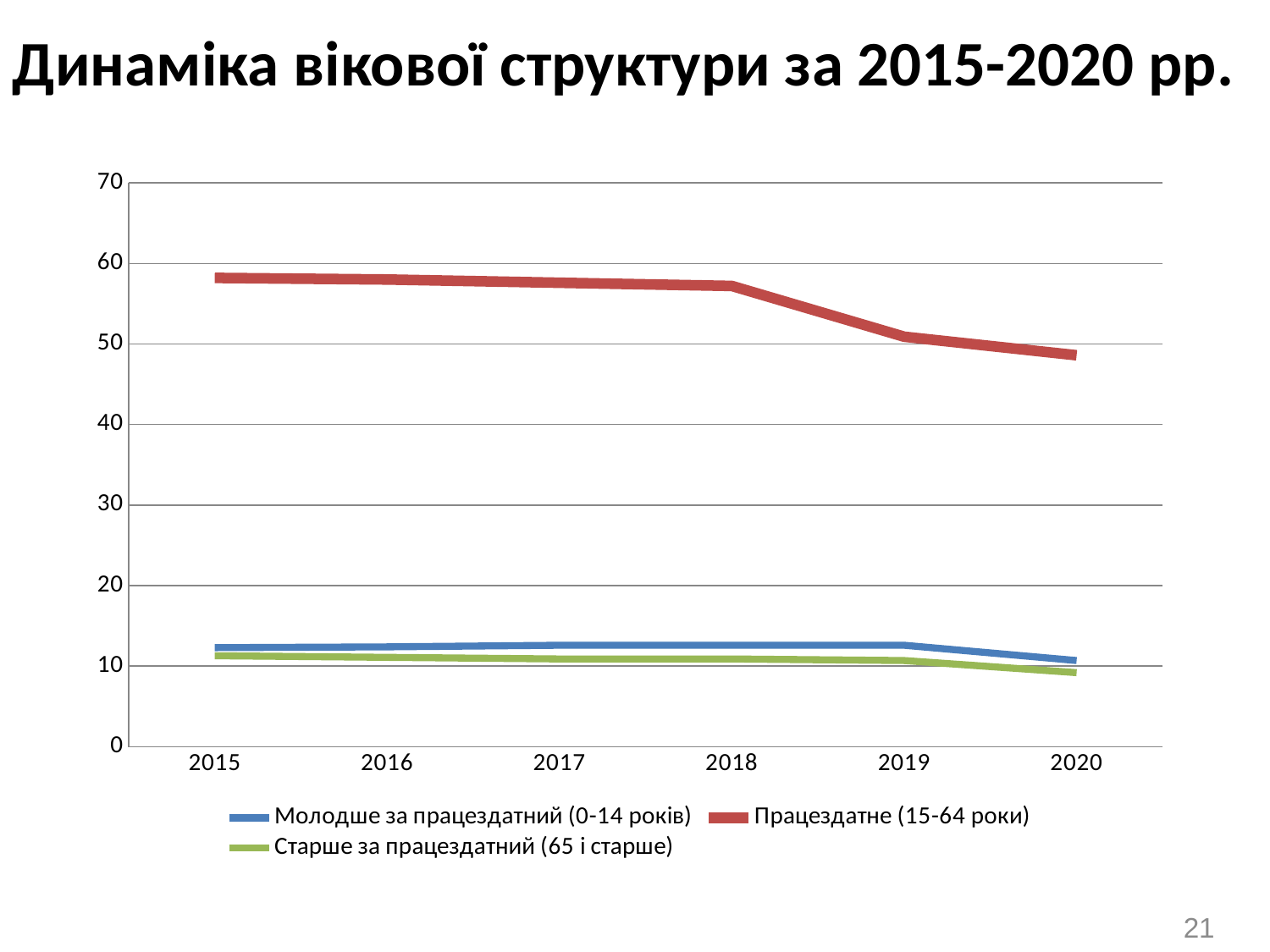
What is the title of the chart? Динаміка вікової структури за 2015-2020 рр. Does the Працездатне (15-64 роки) line rise or fall from 2015 to 2020? Falls How many years are plotted along the x axis? 6 Is the value for Працездатне (15-64 роки) in 2020 greater or less than 50? less How many series does the legend list? 3 In 2020, which is larger: Молодше за працездатний (0-14 років) or Старше за працездатний (65 і старше)? Молодше за працездатний (0-14 років) Is the value for Працездатне (15-64 роки) in 2015 greater or less than 50? greater Is the value for Молодше за працездатний (0-14 років) in 2015 greater or less than 10? greater What kind of chart is shown on the slide? Line chart Which series has the highest values across all years? Працездатне (15-64 роки) Which series has the lowest values across all years? Старше за працездатний (65 і старше) What colour is the line for Працездатне (15-64 роки)? Red